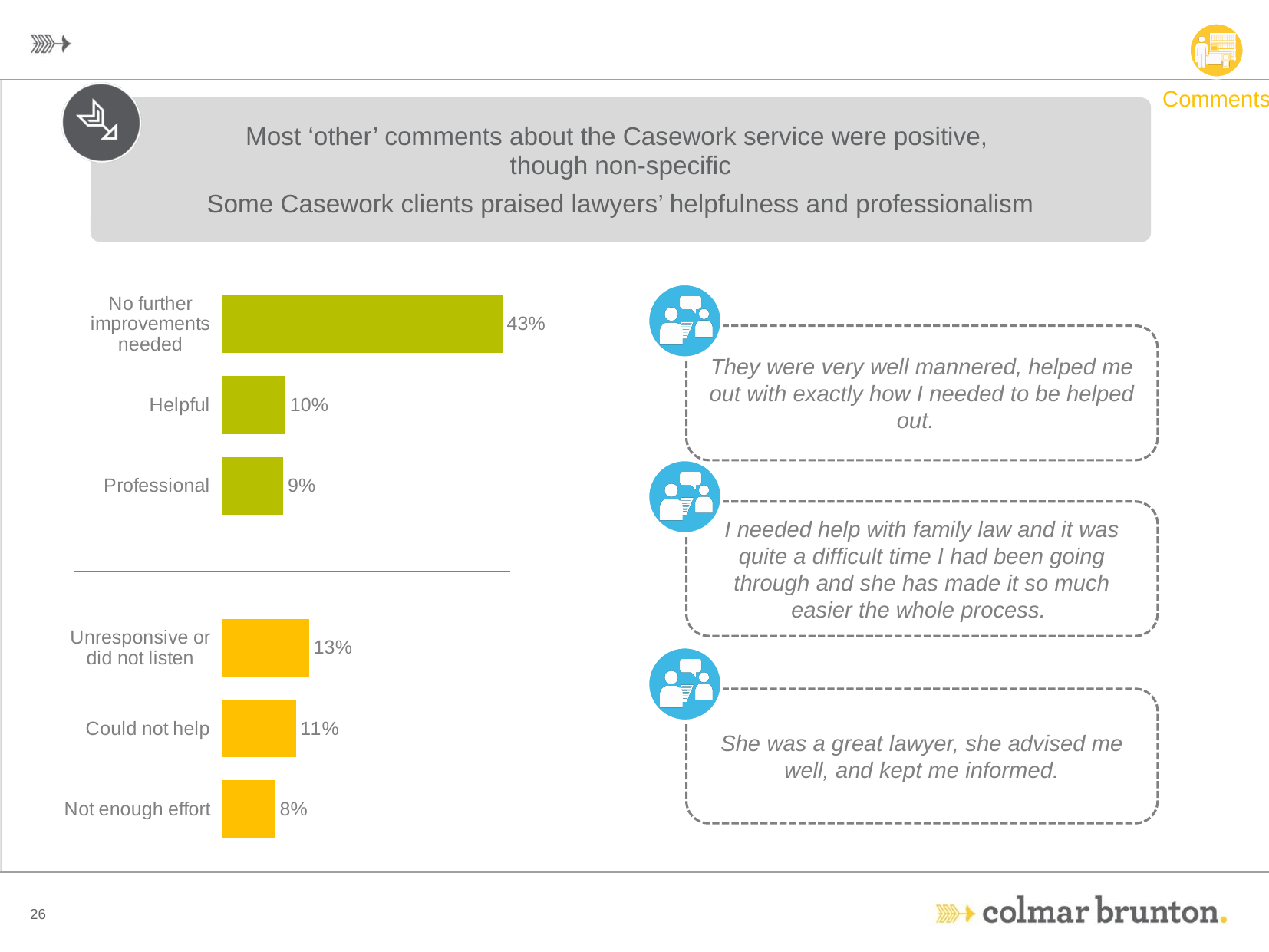
In the upper (green) bar chart, what is the value for 'No further improvements needed'? 43% Which is larger: 'Helpful' in the upper chart or 'Could not help' in the lower chart? Could not help How many categories are shown in the lower (yellow) bar chart? 3 In the upper (green) bar chart, what is the value for 'Helpful'? 10% In the upper (green) bar chart, which category has the lowest value? Professional In the upper (green) bar chart, which category has the highest value? No further improvements needed In the upper (green) bar chart, what is the difference between 'No further improvements needed' and 'Helpful'? 33% In the lower (yellow) bar chart, what is the value for 'Not enough effort'? 8% In the lower (yellow) bar chart, which category has the highest value? Unresponsive or did not listen In the lower (yellow) bar chart, what is the value for 'Could not help'? 11% In the lower (yellow) bar chart, what is the difference between 'Unresponsive or did not listen' and 'Not enough effort'? 5% What type of chart is the upper (green) chart? Bar chart